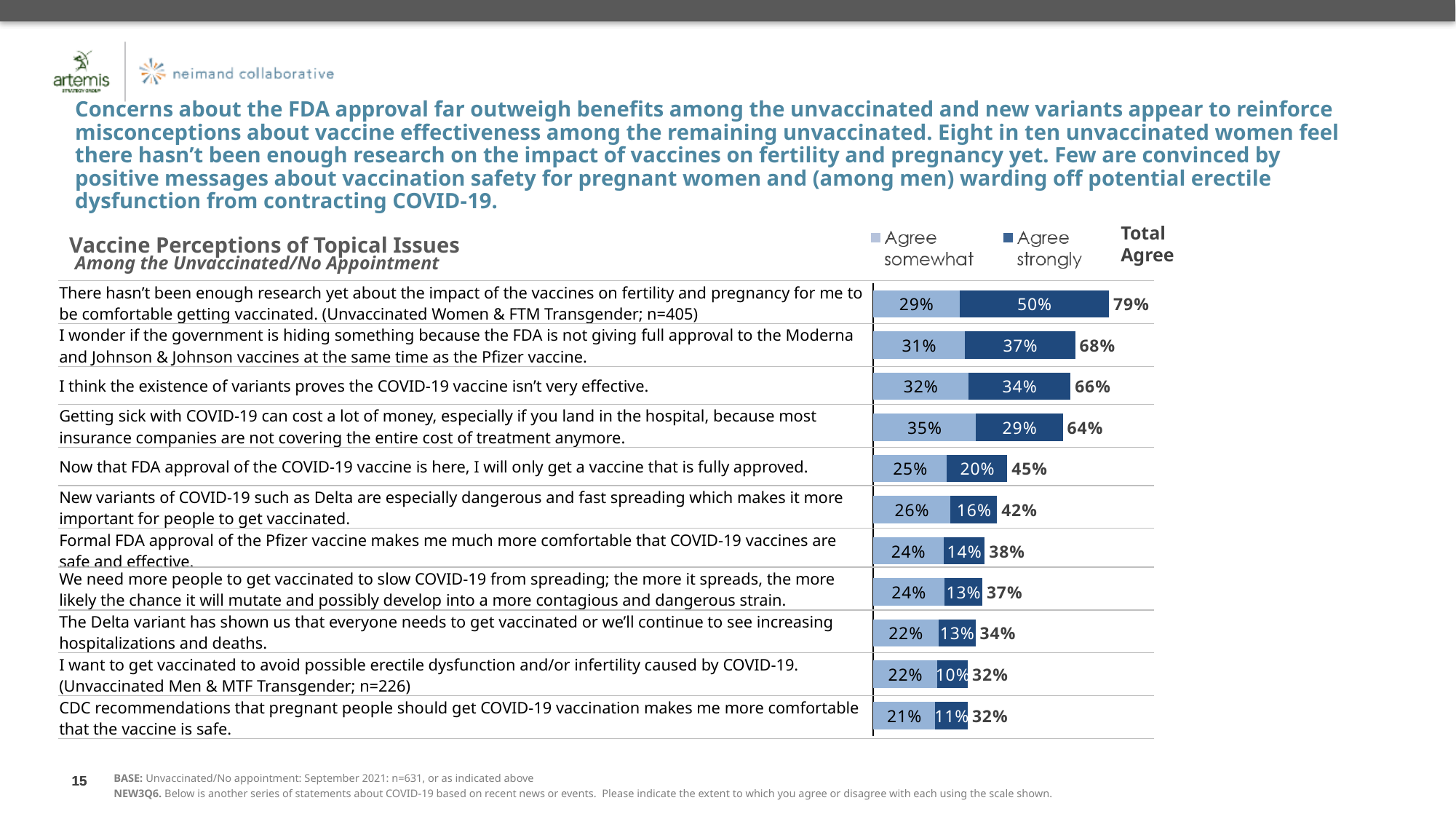
What kind of chart is shown on the slide? Stacked bar chart What is the Total Agree for the statement 'I want to get vaccinated to avoid possible erectile dysfunction and/or infertility caused by COVID-19'? 32% What percentage agree somewhat that getting sick with COVID-19 can cost a lot of money because most insurance companies are not covering the entire cost of treatment anymore? 35% How many statements are shown in the chart? 11 What is the subtitle of the chart, shown beneath 'Vaccine Perceptions of Topical Issues'? Among the Unvaccinated/No Appointment What is the difference in Total Agree between the statement about the government hiding something because the FDA is not giving full approval to Moderna and Johnson & Johnson (68%) and the statement that formal FDA approval of the Pfizer vaccine makes me much more comfortable (38%)? 30 percentage points Which statement has the highest Total Agree value? There hasn't been enough research yet about the impact of the vaccines on fertility and pregnancy for me to be comfortable getting vaccinated. What is the Total Agree value for the statement 'I think the existence of variants proves the COVID-19 vaccine isn't very effective'? 66% What is the lowest 'Agree strongly' value shown in the chart? 10% What percentage of respondents agree strongly that there hasn't been enough research yet about the impact of the vaccines on fertility and pregnancy? 50% Which has a higher 'Agree strongly' value: 'Now that FDA approval of the COVID-19 vaccine is here, I will only get a vaccine that is fully approved' or 'New variants of COVID-19 such as Delta are especially dangerous and fast spreading'? Now that FDA approval of the COVID-19 vaccine is here, I will only get a vaccine that is fully approved How many series does the legend list? 2